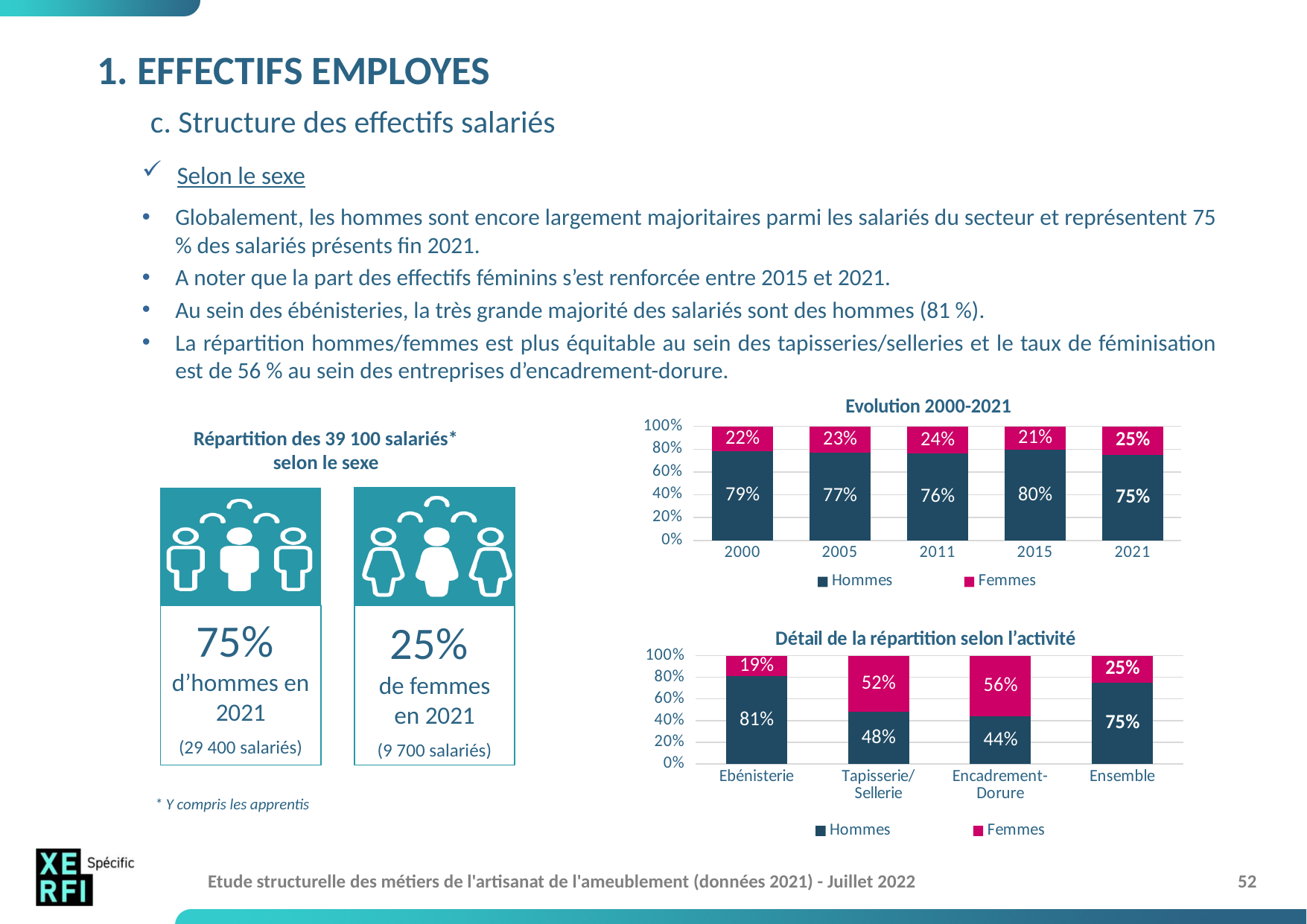
In the 'Evolution 2000-2021' chart, how many series does the legend list? 2 In the 'Evolution 2000-2021' chart, what is the difference between the Femmes share in 2021 and in 2015? 4 percentage points In the 'Evolution 2000-2021' chart, what is the value for Hommes in 2000? 79% In the 'Détail de la répartition selon l'activité' chart, which is larger: the Hommes share in Tapisserie/Sellerie or in Encadrement-Dorure? Tapisserie/Sellerie In the 'Détail de la répartition selon l'activité' chart, which activity has the highest share of Hommes? Ebénisterie In the 'Evolution 2000-2021' chart, how many years are shown on the x axis? 5 In the 'Evolution 2000-2021' chart, which year has the highest share of Hommes? 2015 In the 'Evolution 2000-2021' chart, which year has the lowest share of Femmes? 2015 In the 'Détail de la répartition selon l'activité' chart, what is the value for Femmes in Encadrement-Dorure? 56% In the 'Détail de la répartition selon l'activité' chart, what is the total of the Ebénisterie bar (Hommes plus Femmes)? 100% In the 'Evolution 2000-2021' chart, what is the value for Femmes in 2021? 25% What kind of chart is 'Détail de la répartition selon l'activité'? Stacked bar chart